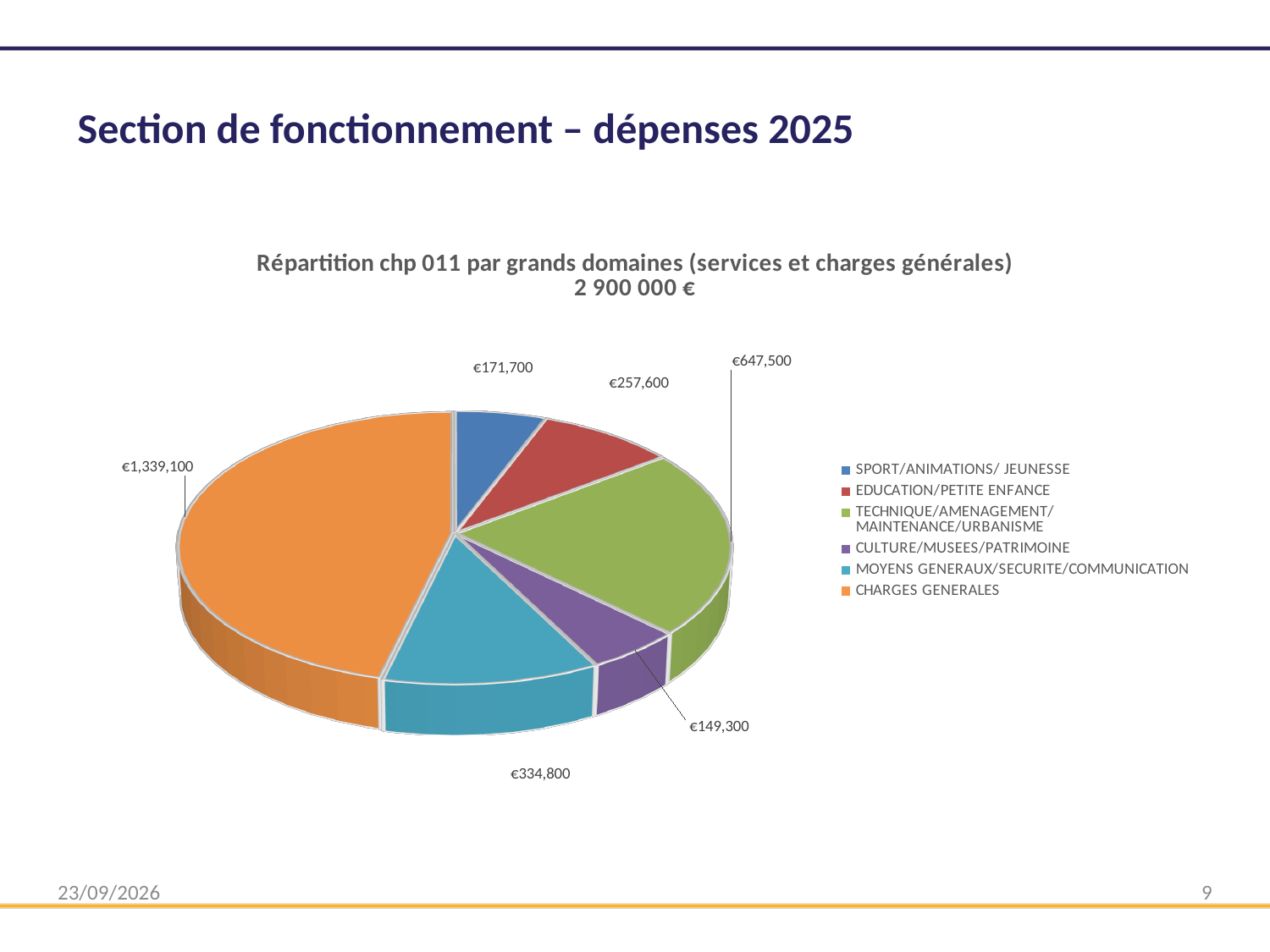
Which is larger, the value for MOYENS GENERAUX/SECURITE/COMMUNICATION or the value for EDUCATION/PETITE ENFANCE? MOYENS GENERAUX/SECURITE/COMMUNICATION What is the value for MOYENS GENERAUX/SECURITE/COMMUNICATION? €334,800 What is the value for TECHNIQUE/AMENAGEMENT/MAINTENANCE/URBANISME? €647,500 What is the value for CHARGES GENERALES? €1,339,100 How many categories does the pie chart show? 6 What is the difference between the values for CHARGES GENERALES and TECHNIQUE/AMENAGEMENT/MAINTENANCE/URBANISME? €691,600 Which category has the smallest slice of the pie? CULTURE/MUSEES/PATRIMOINE What is the difference between the values for EDUCATION/PETITE ENFANCE and SPORT/ANIMATIONS/ JEUNESSE? €85,900 What type of chart is shown on the slide? Pie chart What is the value for CULTURE/MUSEES/PATRIMOINE? €149,300 Which category has the largest slice of the pie? CHARGES GENERALES What total amount is stated in the chart title? 2 900 000 €